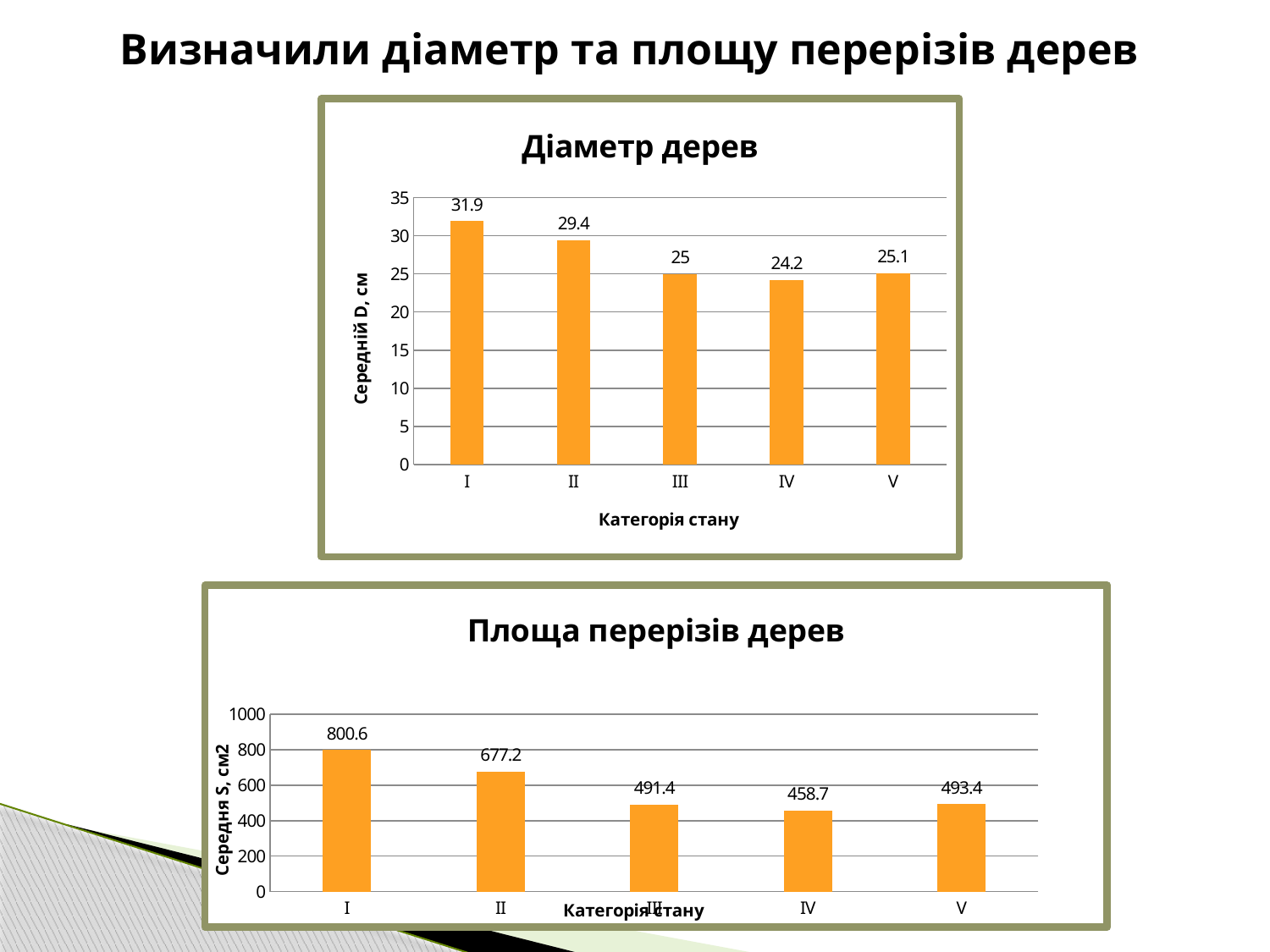
In the "Діаметр дерев" chart, what is the value for category I? 31.9 In the "Площа перерізів дерев" chart, which category has the lowest value? IV In the "Діаметр дерев" chart, what is the difference between the values for category I and category II? 2.5 In the "Площа перерізів дерев" chart, what is the difference between the values for category I and category II? 123.4 In the "Діаметр дерев" chart, which category has the lowest value? IV In the "Площа перерізів дерев" chart, what is the value for category II? 677.2 In the "Діаметр дерев" chart, what is the value for category IV? 24.2 What type of chart is the "Площа перерізів дерев" chart? Bar chart In the "Діаметр дерев" chart, which category has the highest value? I In the "Площа перерізів дерев" chart, what is the value for category V? 493.4 In the "Площа перерізів дерев" chart, is the value for category I larger than the value for category III? Yes In the "Діаметр дерев" chart, how many categories are shown on the x axis? 5